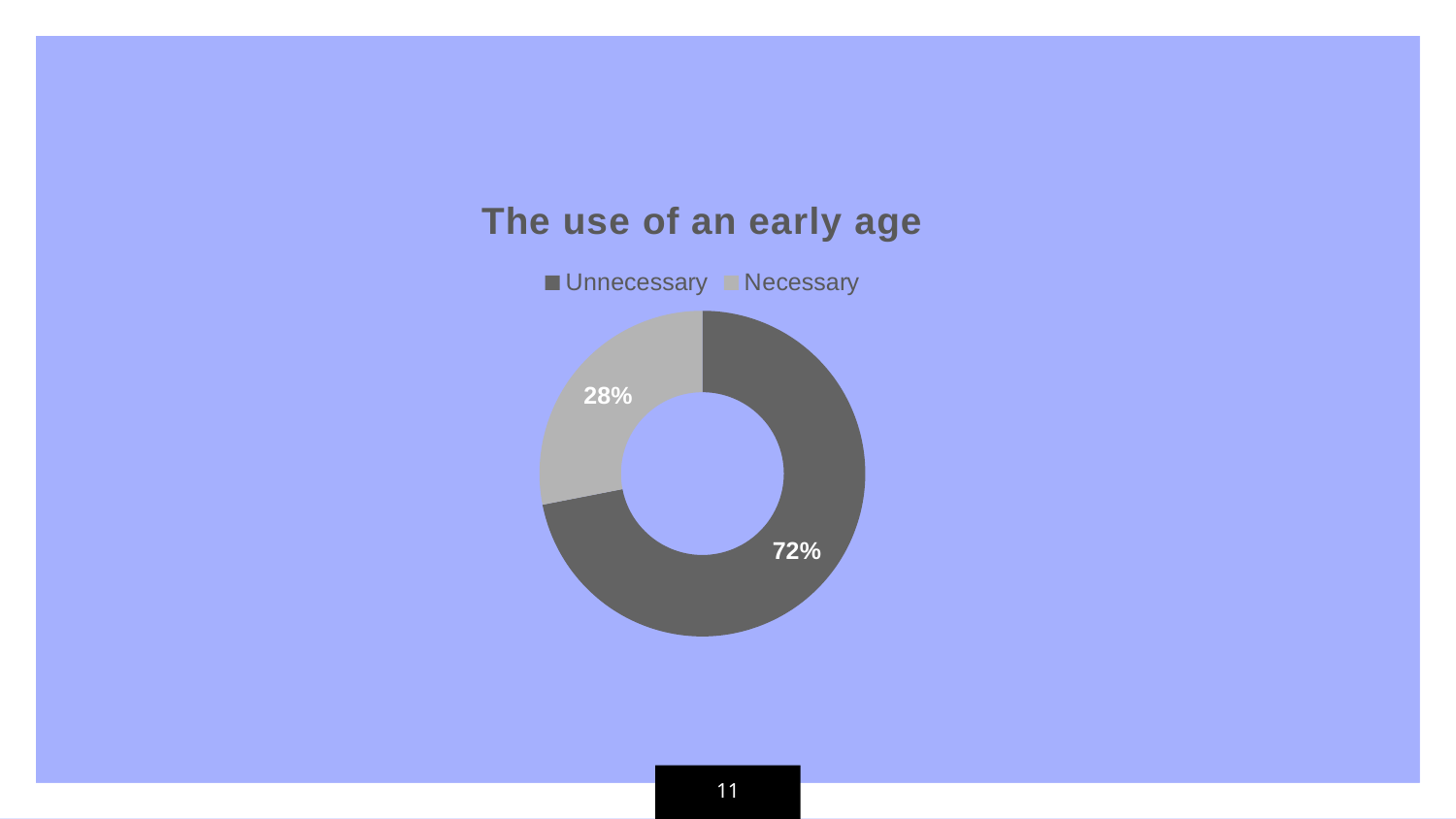
How many slices does the pie chart have? 2 How many entries does the legend list? 2 What is the title of the chart? The use of an early age Which legend entry is shown in the darker grey colour? Unnecessary What share of the pie does the Necessary slice represent? 28% What percentage of the pie chart is labelled Unnecessary? 72% What percentage of the pie chart is labelled Necessary? 28% Which category has the smallest share of the pie chart? Necessary What kind of chart is shown on the slide? Doughnut chart Which slice is larger, Unnecessary or Necessary? Unnecessary Which category has the largest share of the pie chart? Unnecessary What is the difference in percentage points between the Unnecessary and Necessary slices? 44